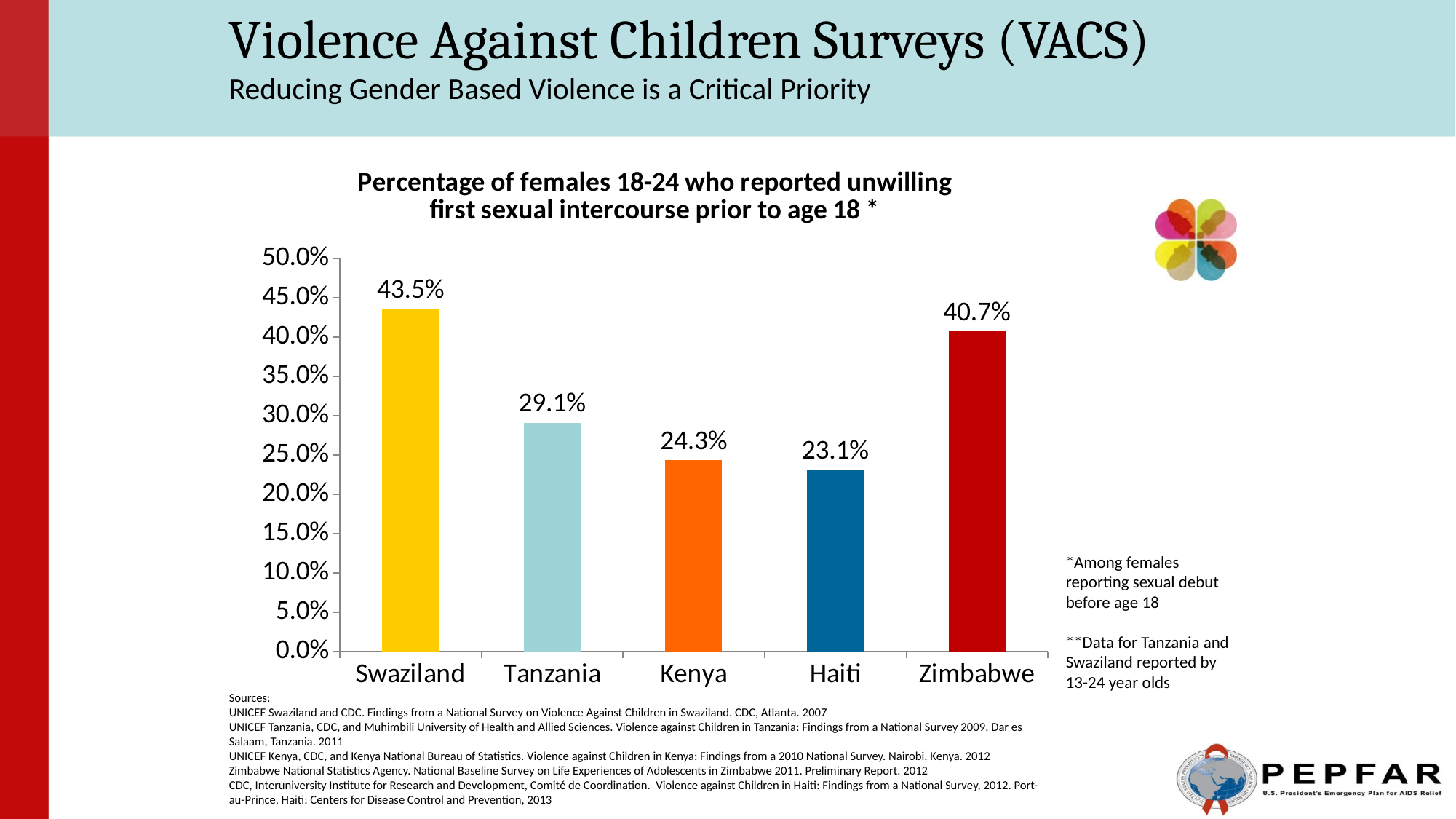
What is the difference between the values for Swaziland and Zimbabwe? 2.8% Which country has the lowest value? Haiti What is the title of the chart? Percentage of females 18-24 who reported unwilling first sexual intercourse prior to age 18 * What is the value for Tanzania? 29.1% What is the value for Swaziland? 43.5% What is the value for Kenya? 24.3% What is the value for Zimbabwe? 40.7% How many countries are shown on the chart? 5 What kind of chart is shown on the slide? Bar chart Which is larger, the value for Tanzania or the value for Kenya? Tanzania What is the value for Haiti? 23.1% Which country has the highest value? Swaziland